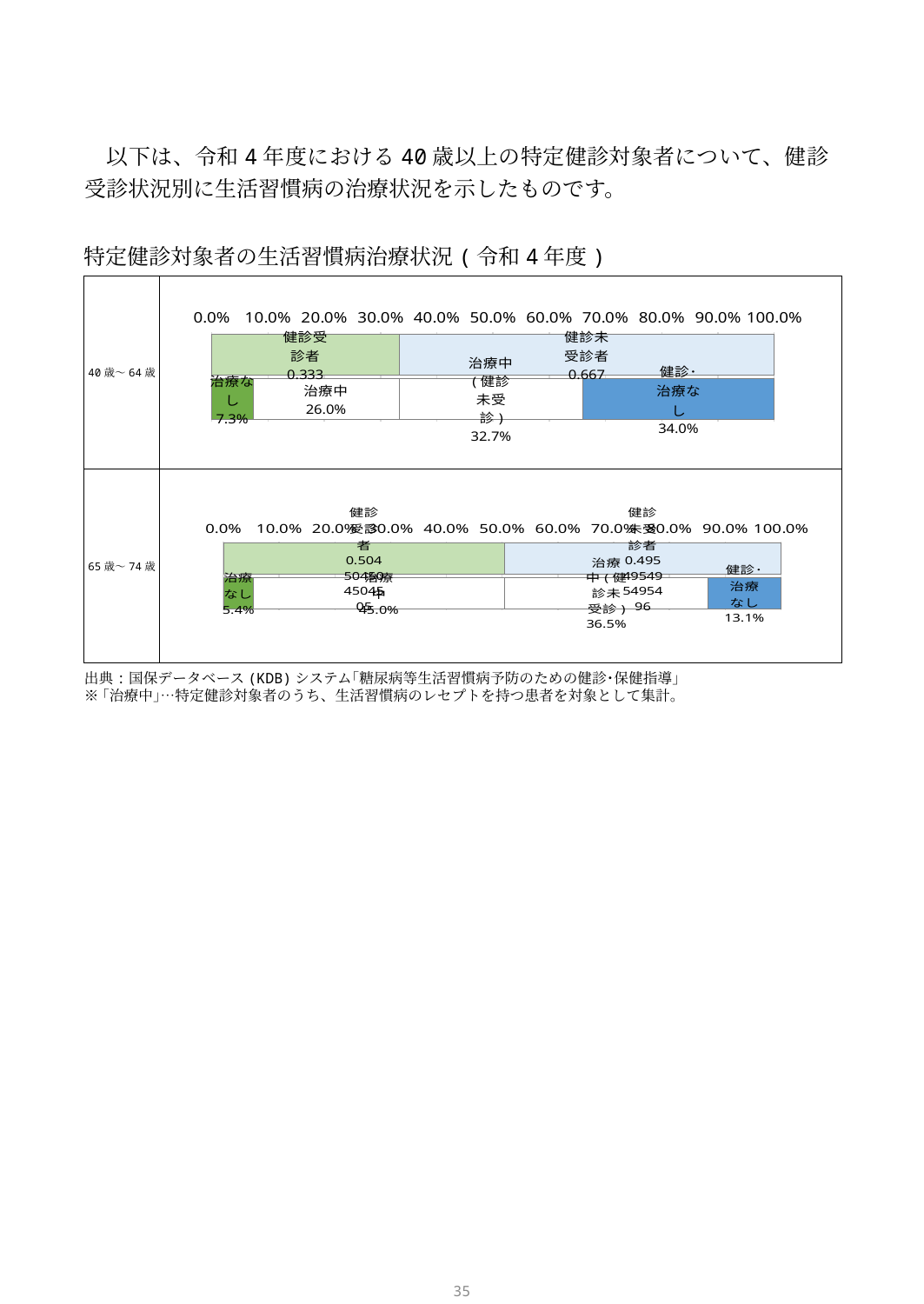
In the 40歳～64歳 chart, which segment of the lower bar is the largest? 健診・治療なし In the 65歳～74歳 chart, what is the value for 治療中（健診未受診）? 36.5% In the 40歳～64歳 chart, what is the value shown for 健診受診者 in the top bar? 0.333 In the 40歳～64歳 chart, what is the value for 治療なし (among 健診受診者)? 7.3% In the 40歳～64歳 chart, what is the value for 健診・治療なし? 34.0% In the 40歳～64歳 chart, which segment of the lower bar is the smallest? 治療なし What kind of chart is used for the 40歳～64歳 data? Stacked bar chart In the 65歳～74歳 chart, what is the value for 治療なし (among 健診受診者)? 5.4% In the 40歳～64歳 chart, what is the value for 治療中 (among 健診受診者)? 26.0% In the 40歳～64歳 chart, what is the value for 治療中（健診未受診）? 32.7% In the 65歳～74歳 chart, what is the value for 健診・治療なし? 13.1% In the 40歳～64歳 chart, what is the difference between 健診・治療なし and 治療中（健診未受診）? 1.3%